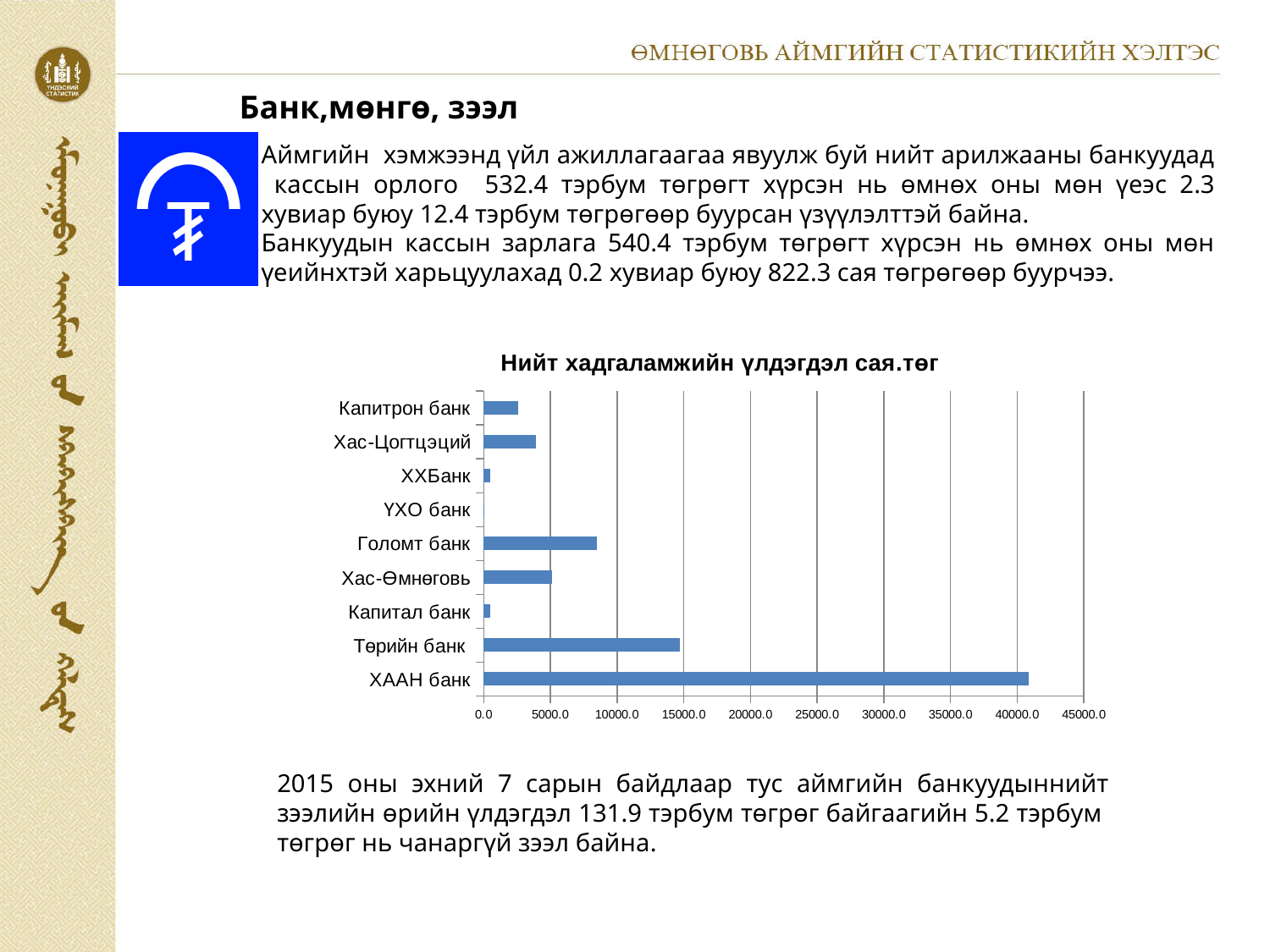
Is the value for ХААН банк greater or less than 35000.0? greater How many banks are listed as categories in the chart? 9 What kind of chart is shown on the slide? Bar chart Is the value for Голомт банк greater or less than 10000.0? less Which is larger, the value for Голомт банк or the value for Хас-Өмнөговь? Голомт банк Is the value for Капитрон банк greater or less than 5000.0? less What colour are the bars in the chart? Blue Which bank has the highest value in the chart? ХААН банк What is the title of the chart? Нийт хадгаламжийн үлдэгдэл сая.төг Which is larger, the value for Төрийн банк or the value for Голомт банк? Төрийн банк Which bank has the lowest value in the chart? ҮХО банк